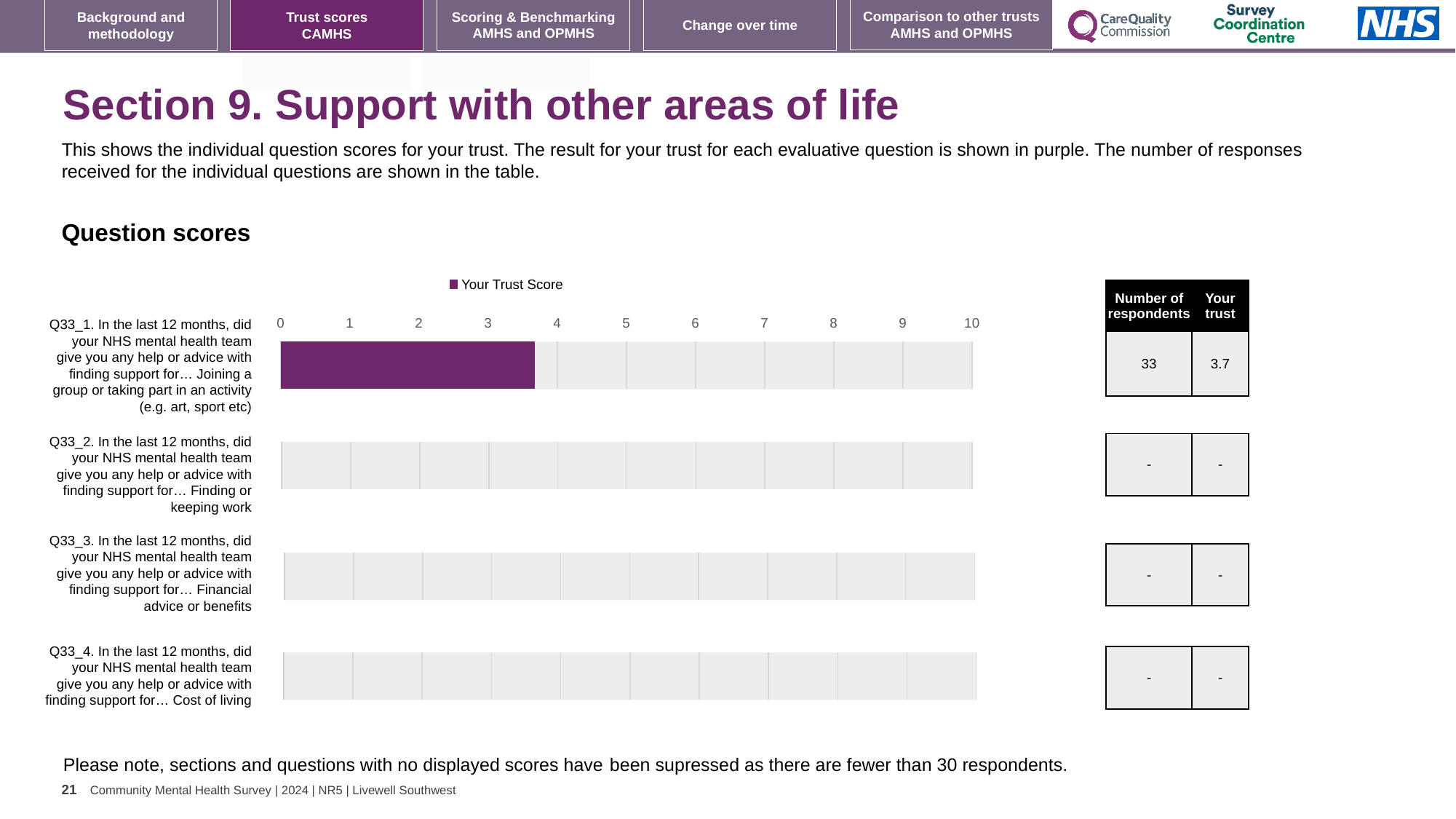
What kind of chart is shown under 'Question scores'? bar chart What is shown in the table for the number of respondents and trust score for Q33_2? - What is the legend entry for the chart? Your Trust Score What colour is the bar showing the trust score? purple Which question has a displayed trust score bar on the chart? Q33_1 Is the trust score bar for Q33_1 greater or less than 4? less What is the trust score for Q33_1 (help or advice with joining a group or taking part in an activity)? 3.7 How many series does the chart legend list? 1 Is the trust score bar for Q33_1 greater or less than 3? greater How many of the four questions have a displayed trust score? 1 How many questions (categories) are listed on the chart? 4 How many respondents answered Q33_1? 33